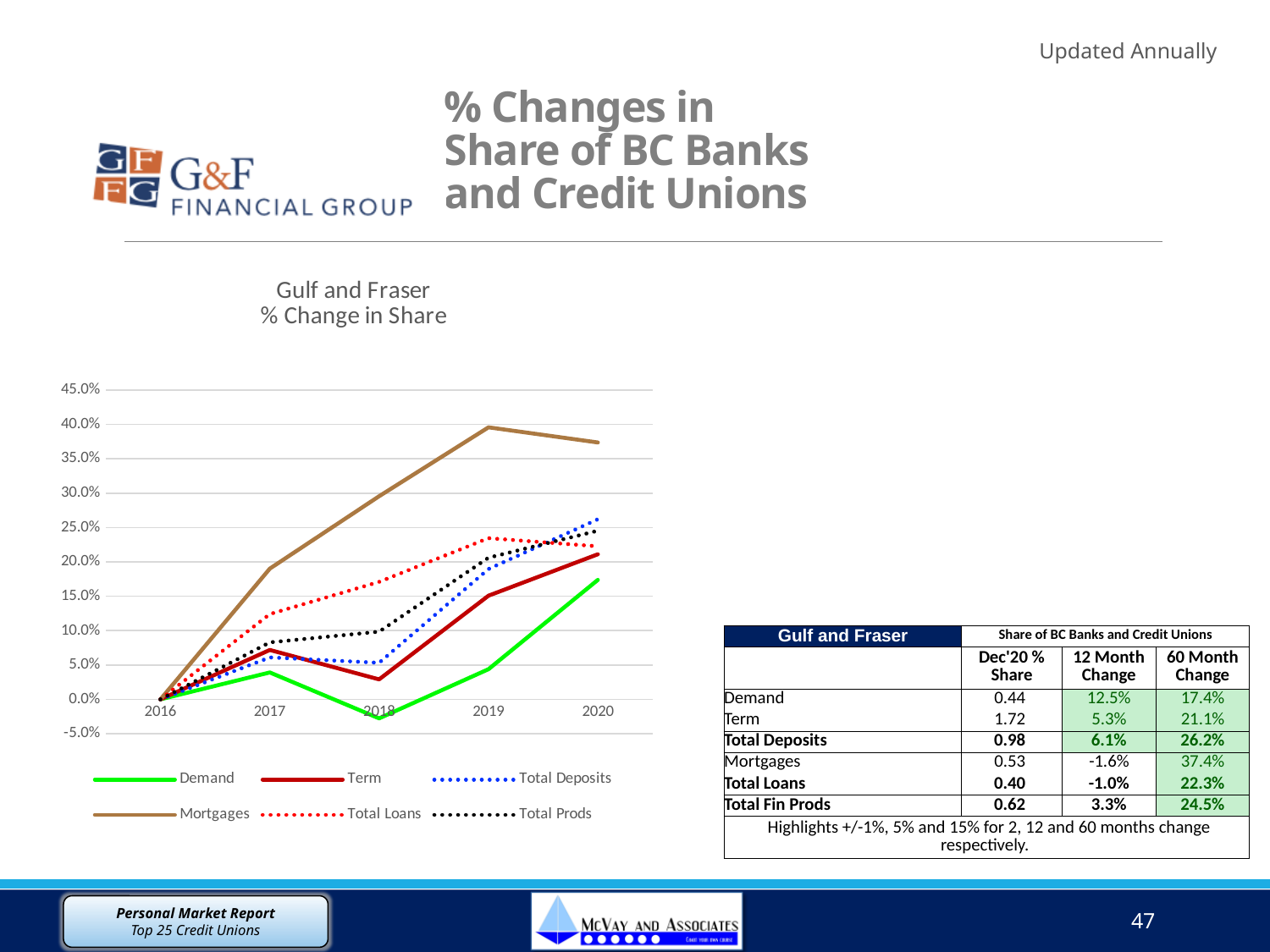
Is the value for Term in 2018 greater or less than 5.0%? less What is the title of the chart? Gulf and Fraser % Change in Share Which series has the highest value in 2020? Mortgages Is the value for Demand in 2018 greater or less than 0.0%? less Is the value for Mortgages in 2019 greater or less than 35.0%? greater What kind of chart is shown on the slide? line chart In 2019, which is larger: the value for Mortgages or the value for Demand? Mortgages How many years are shown along the x axis of the chart? 5 Does the Mortgages line rise or fall from 2016 to 2019? rise How many series does the chart legend list? 6 Which series has the lowest value in 2018? Demand